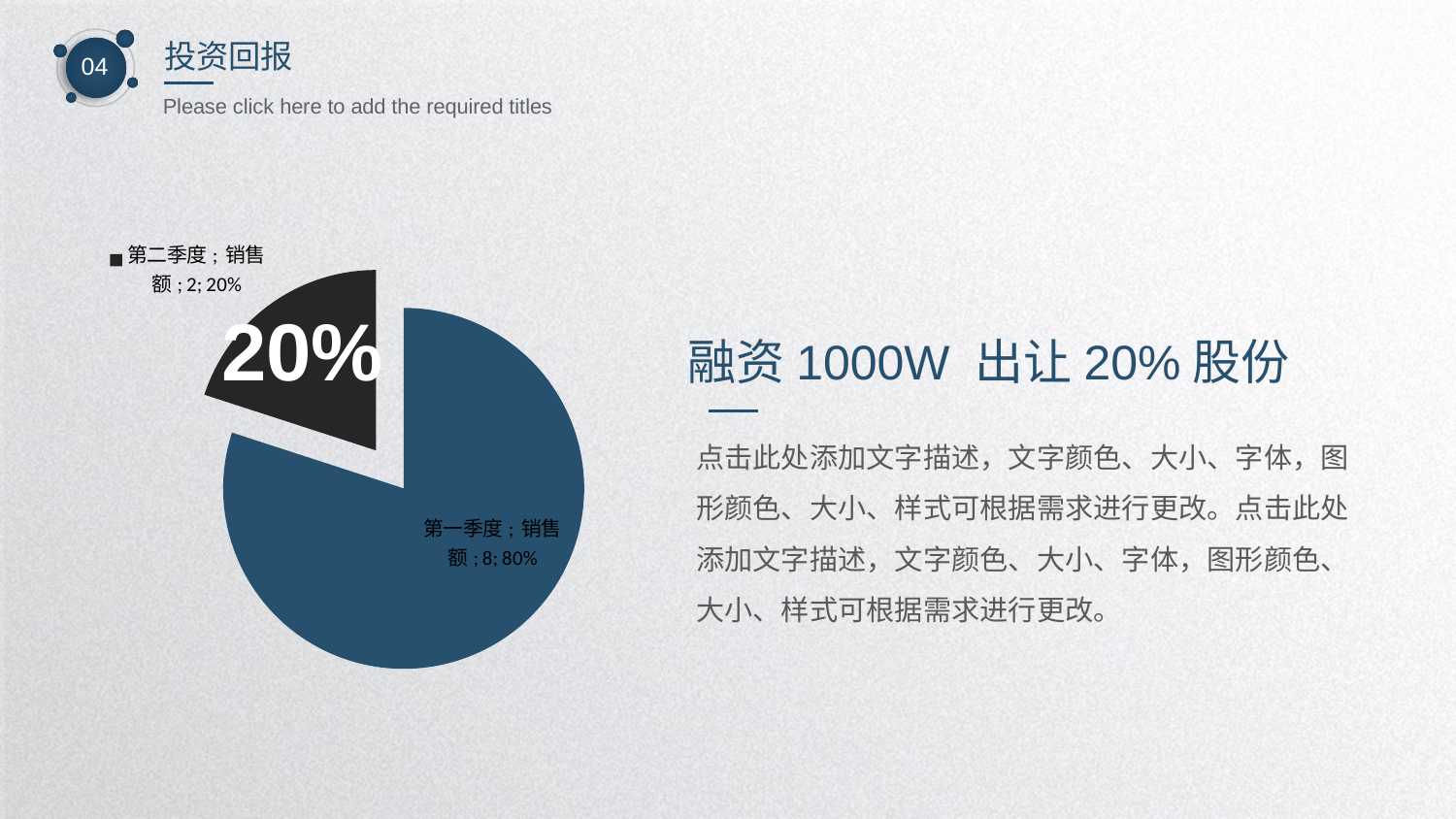
How many slices does the pie chart have? 2 What is the total of the two values in the pie chart? 10 What is the value shown for 第二季度 in the pie chart? 2 Which category has the largest slice in the pie chart? 第一季度 What percentage share of the pie does 第一季度 have? 80% Which is larger, the value for 第一季度 or the value for 第二季度? 第一季度 What is the value shown for 第一季度 in the pie chart? 8 What kind of chart is shown on the slide? pie chart What percentage share of the pie does 第二季度 have? 20% What is the difference between the values for 第一季度 and 第二季度? 6 Which category has the smallest slice in the pie chart? 第二季度 What series name is shown in the pie chart's data labels? 销售额